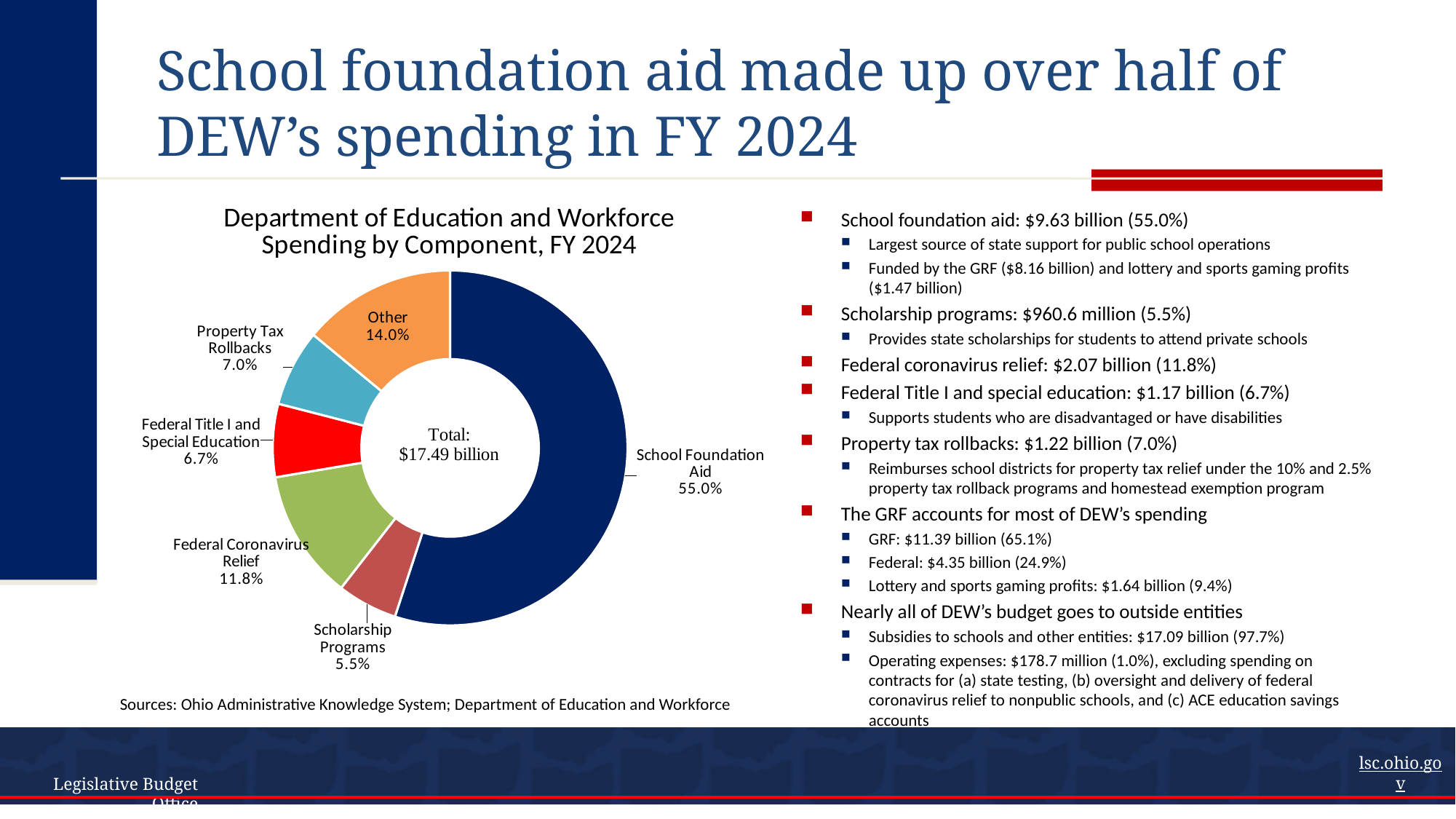
What percentage of spending is shown for Property Tax Rollbacks? 7.0% What share of spending does School Foundation Aid account for in the chart? 55.0% What kind of chart is shown on the slide? Pie chart (donut) What is the difference in percentage points between the Other slice and the Scholarship Programs slice? 8.5 percentage points Which component has the largest share of spending in the chart? School Foundation Aid Which component has the smallest share of spending in the chart? Scholarship Programs How many components are shown in the chart? 6 What total is printed in the center of the chart? $17.49 billion What percentage of spending is shown for Federal Coronavirus Relief? 11.8% What colour is the School Foundation Aid slice? Dark blue What is the title of the chart? Department of Education and Workforce Spending by Component, FY 2024 Which is larger: the share for Federal Coronavirus Relief or the share for Federal Title I and Special Education? Federal Coronavirus Relief